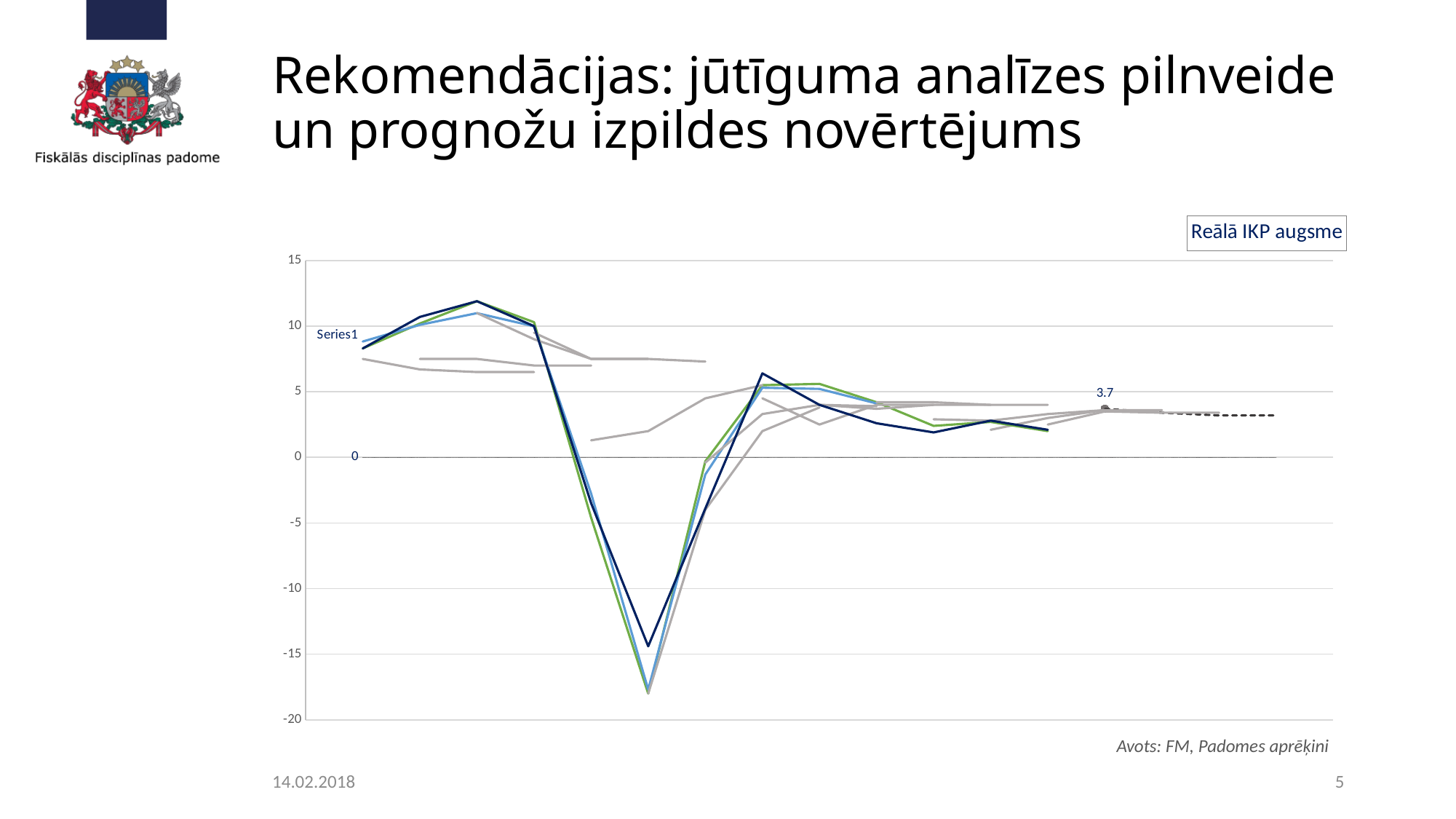
At the deep trough in the middle of the chart, is the dark navy line higher or lower than the green line? higher Is the highest point of the dark navy line greater or less than 10? greater What is the title shown in the box above the chart? Reālā IKP augsme What value is printed as a data label near the right end of the dark navy line? 3.7 Is the value labelled 3.7 on the dark navy line greater or less than 5? less Immediately after the deep trough, do the coloured lines rise or fall? rise Between the peak on the left and the deep trough, do the coloured lines rise or fall? fall What is the lowest tick value shown on the vertical axis? -20 Is the lowest point of the green line greater or less than -15? less What kind of chart is shown on the slide? line chart